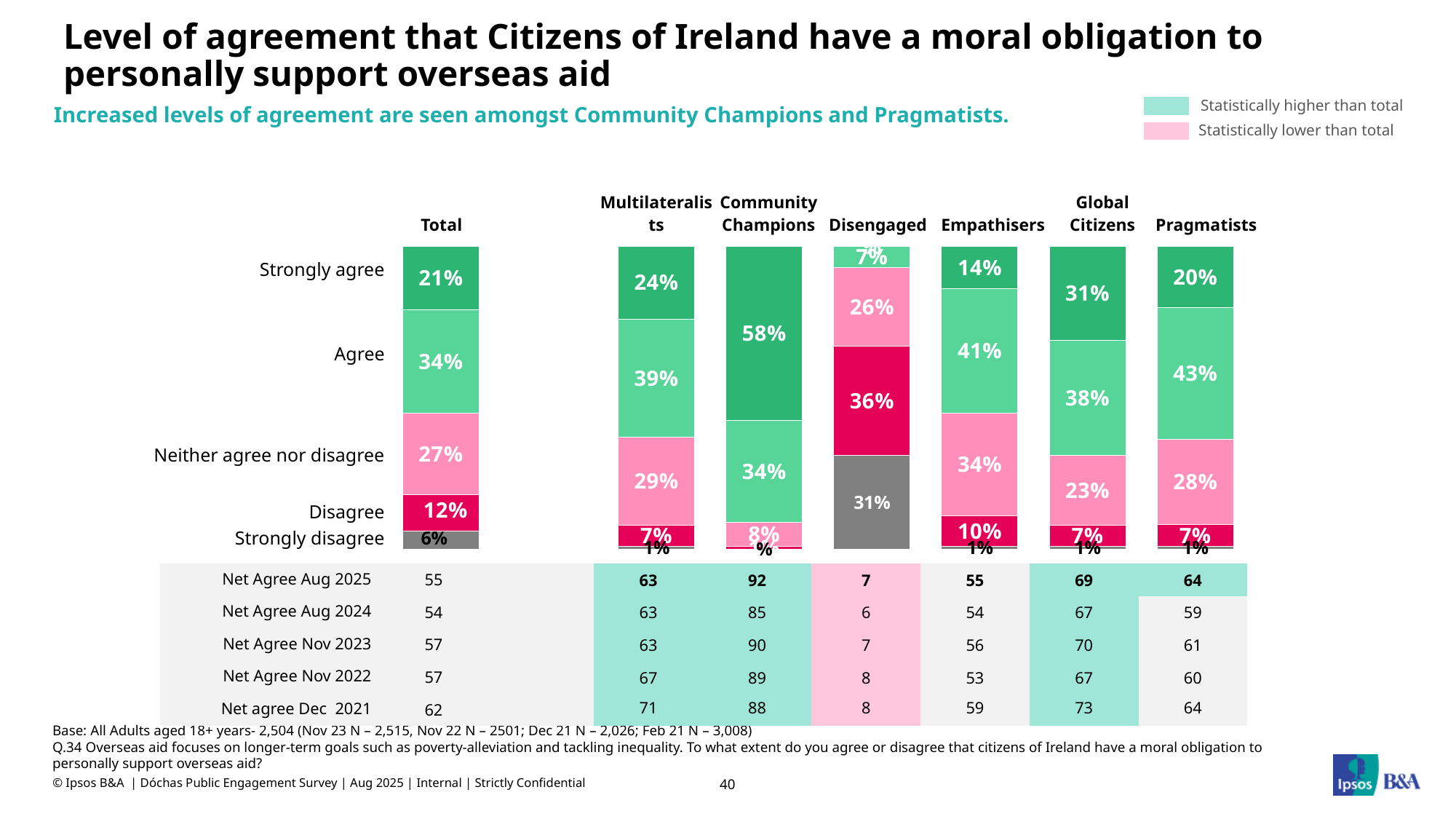
What percentage of the Total 'Strongly disagree'? 6% Which segment has the highest 'Strongly agree' percentage? Community Champions What percentage of the Total strongly agree that citizens of Ireland have a moral obligation to personally support overseas aid? 21% How many audience segments are shown in the chart in addition to the Total? 6 What percentage of the Disengaged segment 'Disagree'? 36% What kind of chart is used on this slide? Stacked bar chart What is the Net Agree Aug 2025 figure for Community Champions? 92 Which has a larger 'Neither agree nor disagree' share, Empathisers or Global Citizens? Empathisers How many percentage points higher is the 'Agree' share for Multilateralists than for the Total? 5 percentage points Which segment has the lowest Net Agree Aug 2025 figure? Disengaged What percentage of Pragmatists 'Agree'? 43% What is the difference between the Net Agree Aug 2025 figure for Global Citizens and for the Total? 14